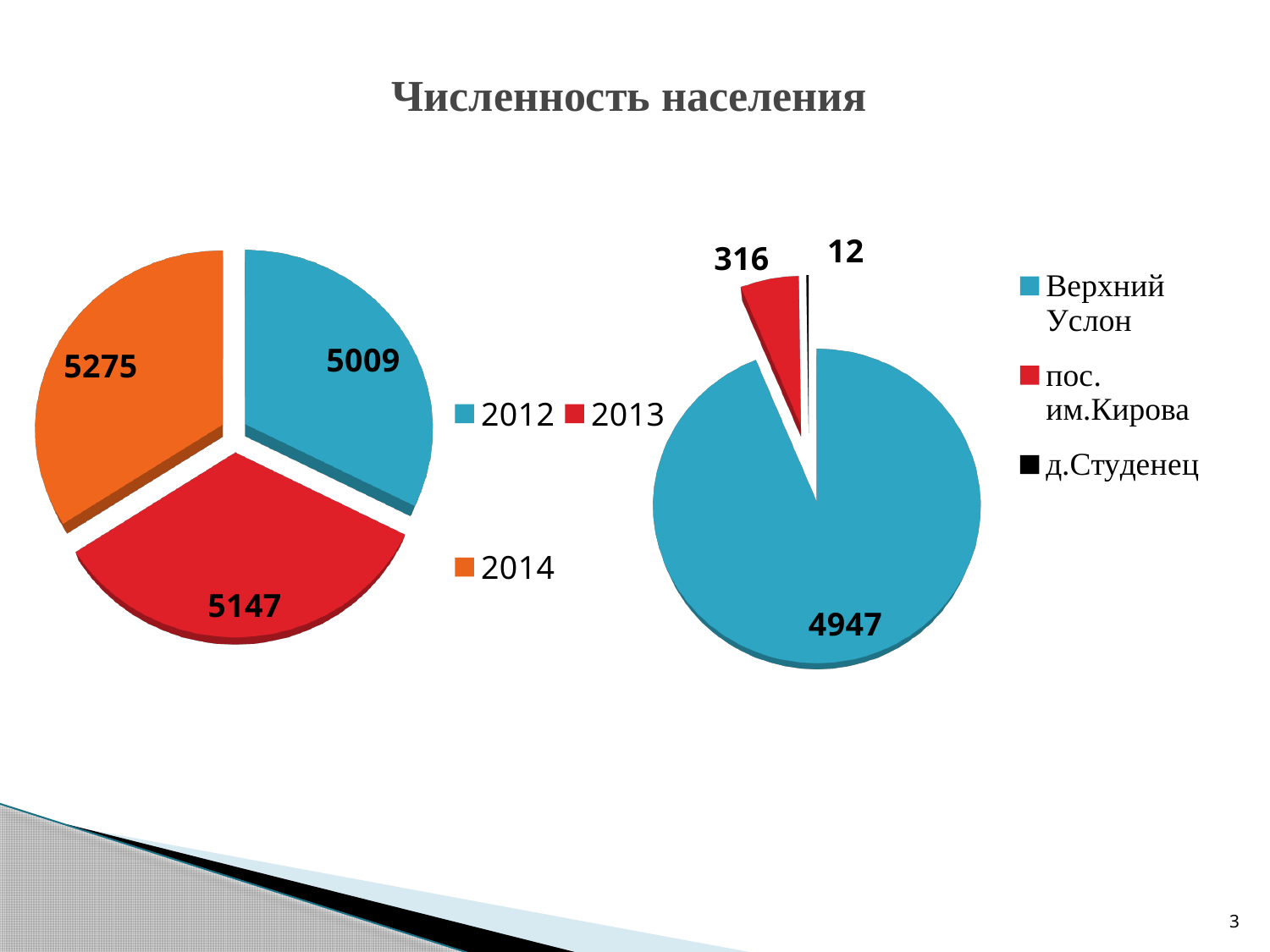
On the right pie chart, what is the difference between the values for пос. им.Кирова and д.Студенец? 304 On the left pie chart, which year has the smallest value? 2012 On the left pie chart, what is the value for 2014? 5275 On the right pie chart, what is the value for Верхний Услон? 4947 On the left pie chart, do the values rise or fall from 2012 to 2014? rise On the right pie chart, what is the value for пос. им.Кирова? 316 On the left pie chart, what is the value for 2012? 5009 How many categories does the legend of the right pie chart list? 3 On the right pie chart, which category has the smallest value? д.Студенец What type of chart is the left chart on the slide? pie chart On the left pie chart, which year has the largest value? 2014 On the left pie chart, what is the difference between the values for 2014 and 2012? 266